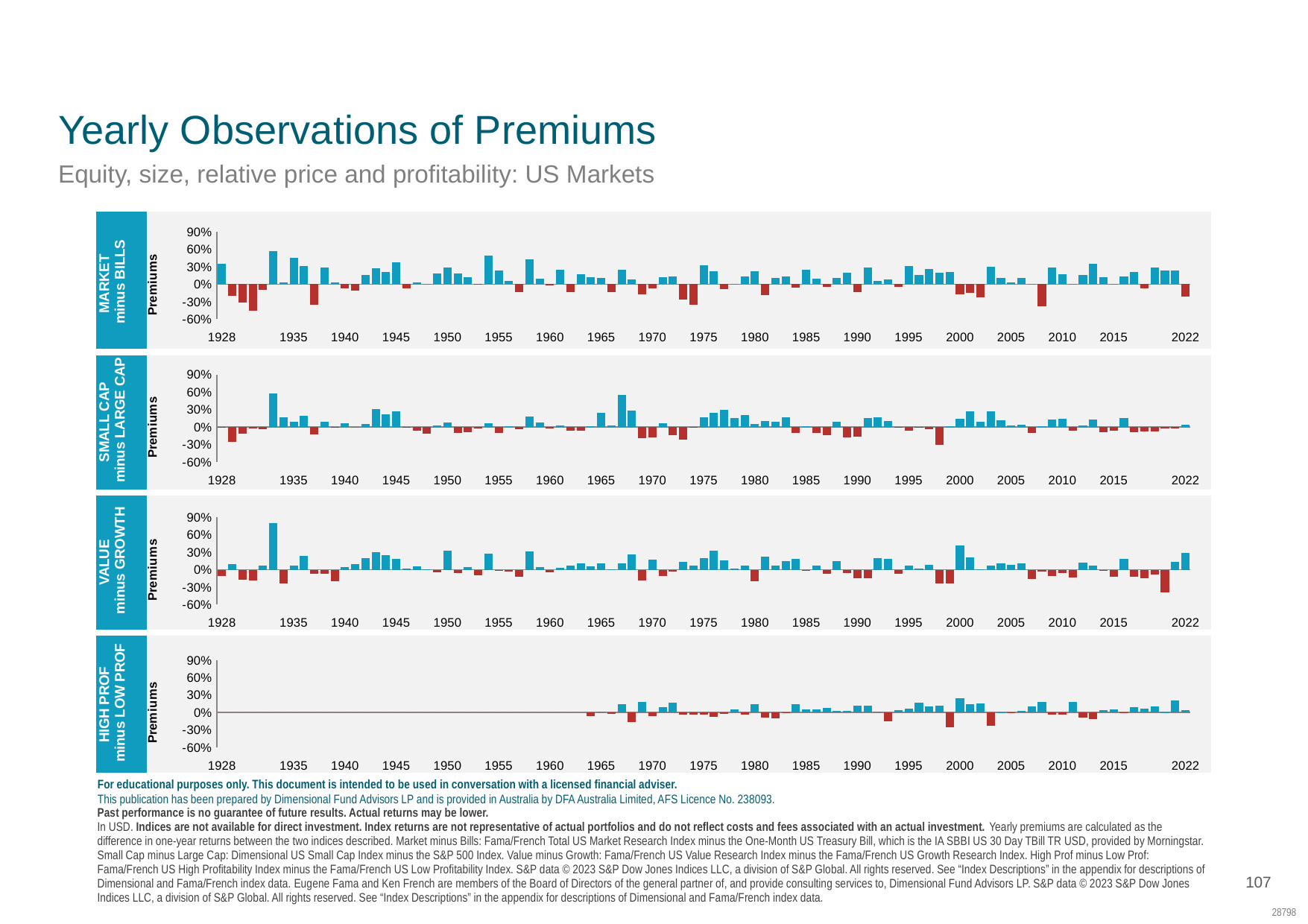
What is the last year shown on the x axis of the charts? 2022 What is the title of the bottom chart panel? HIGH PROF minus LOW PROF In the VALUE minus GROWTH chart, is the tallest bar greater or less than 60%? greater What kind of chart is used in each of the four panels on the slide? Bar chart In the HIGH PROF minus LOW PROF chart, are there any bars plotted before 1960? No What is the lowest value labelled on the y axis of the charts? -60% What is the title of the top chart panel? MARKET minus BILLS What is the highest value labelled on the y axis of the charts? 90% In the MARKET minus BILLS chart, is the tallest bar greater or less than 30%? greater What is the first year shown on the x axis of the charts? 1928 How many charts (panels) are shown on the slide? 4 In the SMALL CAP minus LARGE CAP chart, is the tallest bar greater or less than 30%? greater